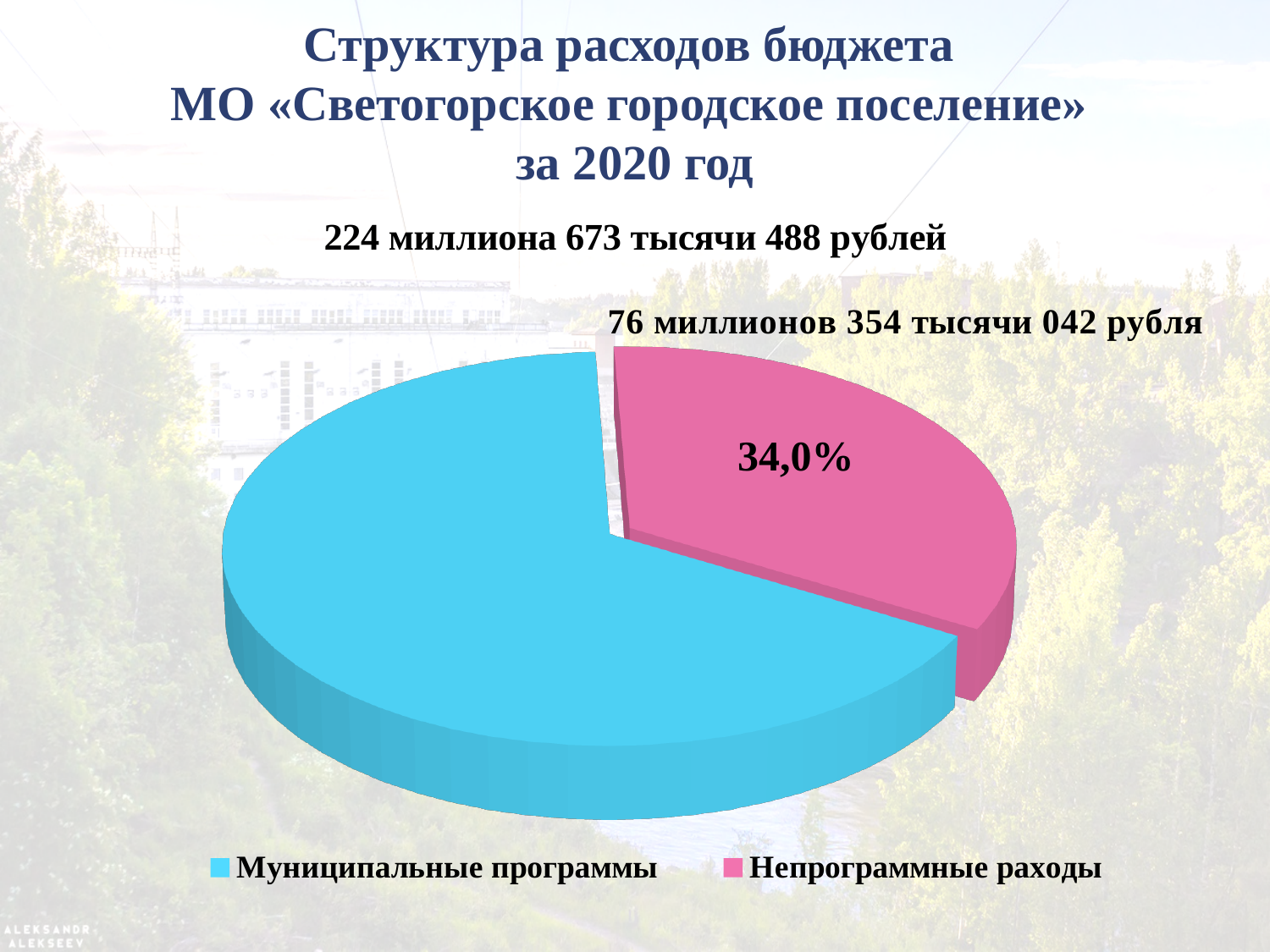
Which slice is larger, Муниципальные программы or Непрограммные раходы? Муниципальные программы What share of the pie is labelled for Непрограммные раходы? 34,0% Is the share for Непрограммные раходы greater or less than 50%? less Which year does the chart title say the budget expenditure structure is for? 2020 What amount in rubles is printed next to the Непрограммные раходы slice? 76 миллионов 354 тысячи 042 рубля What colour is the Непрограммные раходы slice? pink How many slices does the pie chart have? 2 What kind of chart is shown on the slide? pie chart Which category has the largest slice of the pie? Муниципальные программы Which category has the smallest slice of the pie? Непрограммные раходы How many entries does the legend list? 2